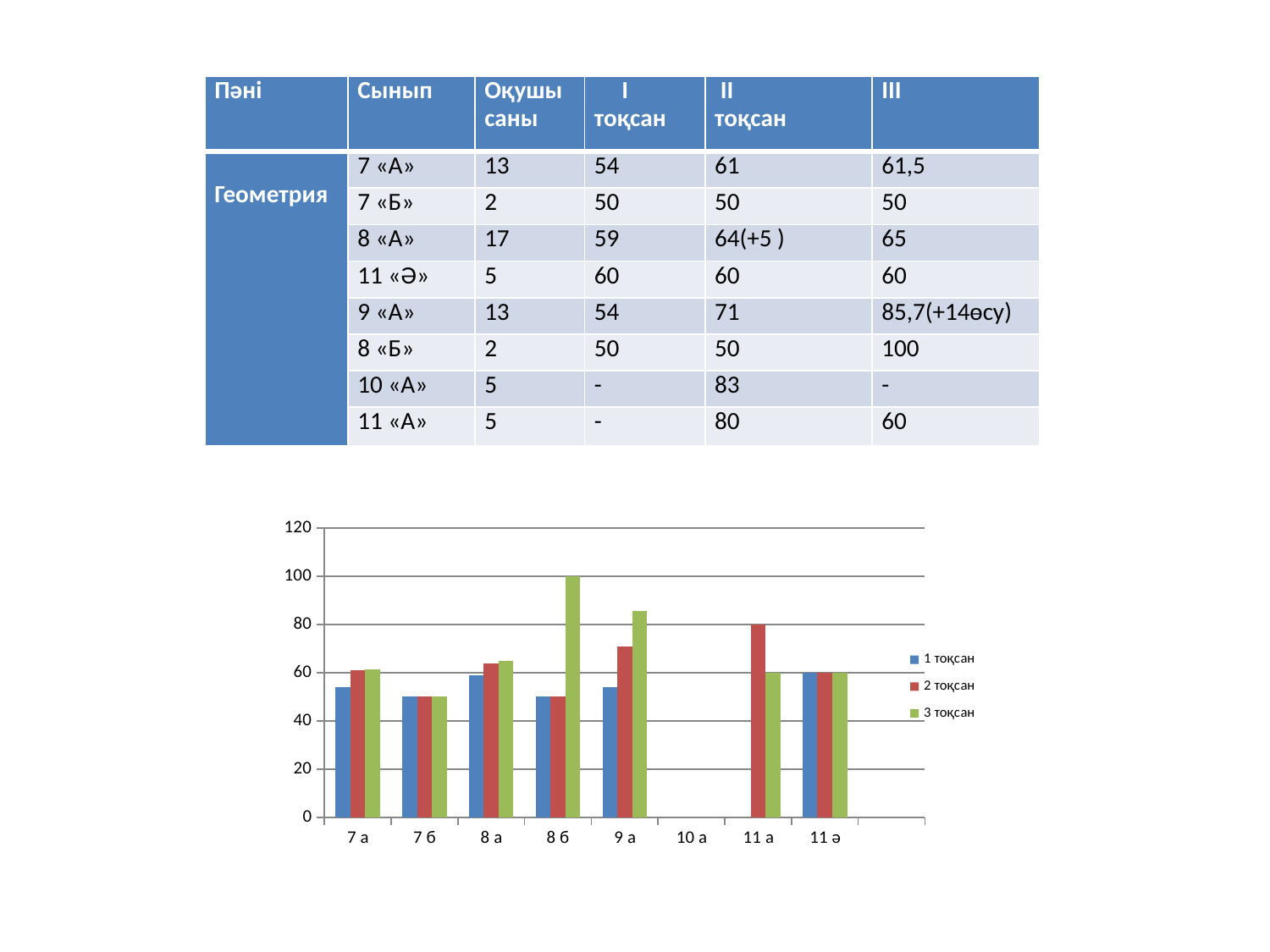
What kind of chart is shown on the slide? bar chart How many categories are shown on the x axis of the chart? 8 What is the value of the 2 тоқсан bar for 11 а in the chart? 80 What colour are the 2 тоқсан bars in the chart? red Is the 1 тоқсан value for 7 а greater or less than 60? less What is the value of the 3 тоқсан bar for 11 ә in the chart? 60 Is the 3 тоқсан value for 9 а greater or less than 80? greater What is the value of the 3 тоқсан bar for 8 б in the chart? 100 Which category has the tallest bar in the chart? 8 б Which category in the chart has no bars plotted at all? 10 а Which is larger in the chart: the 2 тоқсан bar for 9 а or the 2 тоқсан bar for 7 б? 9 а How many series does the chart legend list? 3